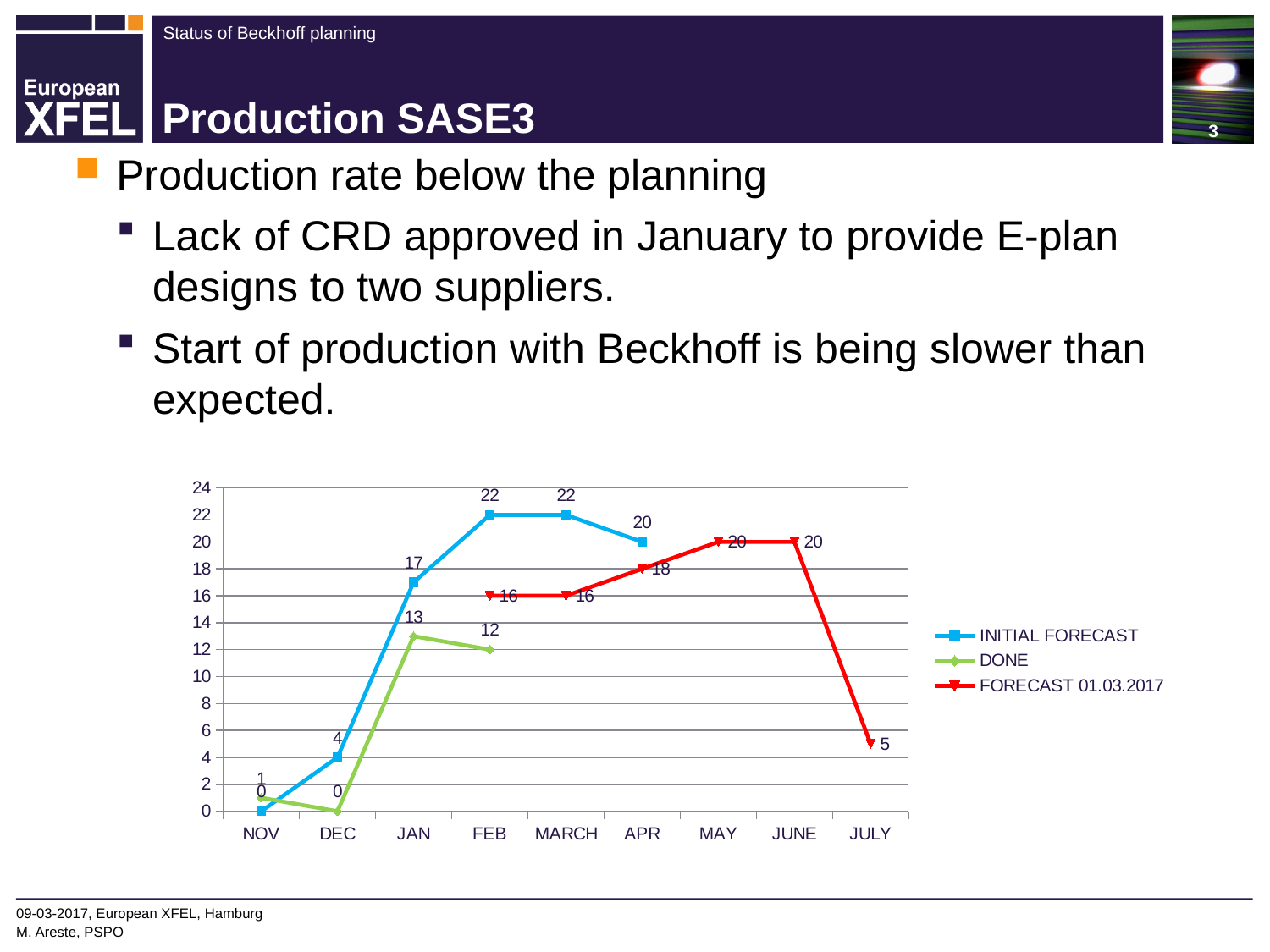
What kind of chart is shown on the slide? Line chart In which month is the FORECAST 01.03.2017 series at its lowest value? JULY In FEB, which is larger: the INITIAL FORECAST value or the FORECAST 01.03.2017 value? INITIAL FORECAST What is the difference between the INITIAL FORECAST and DONE values in JAN? 4 What is the INITIAL FORECAST value for JAN? 17 Which series is drawn in red? FORECAST 01.03.2017 How many months are shown on the x axis? 9 What is the FORECAST 01.03.2017 value for JULY? 5 How many series does the legend list? 3 Does the DONE series rise or fall from JAN to FEB? Fall What is the DONE value for FEB? 12 In which month does the DONE series reach its highest value? JAN